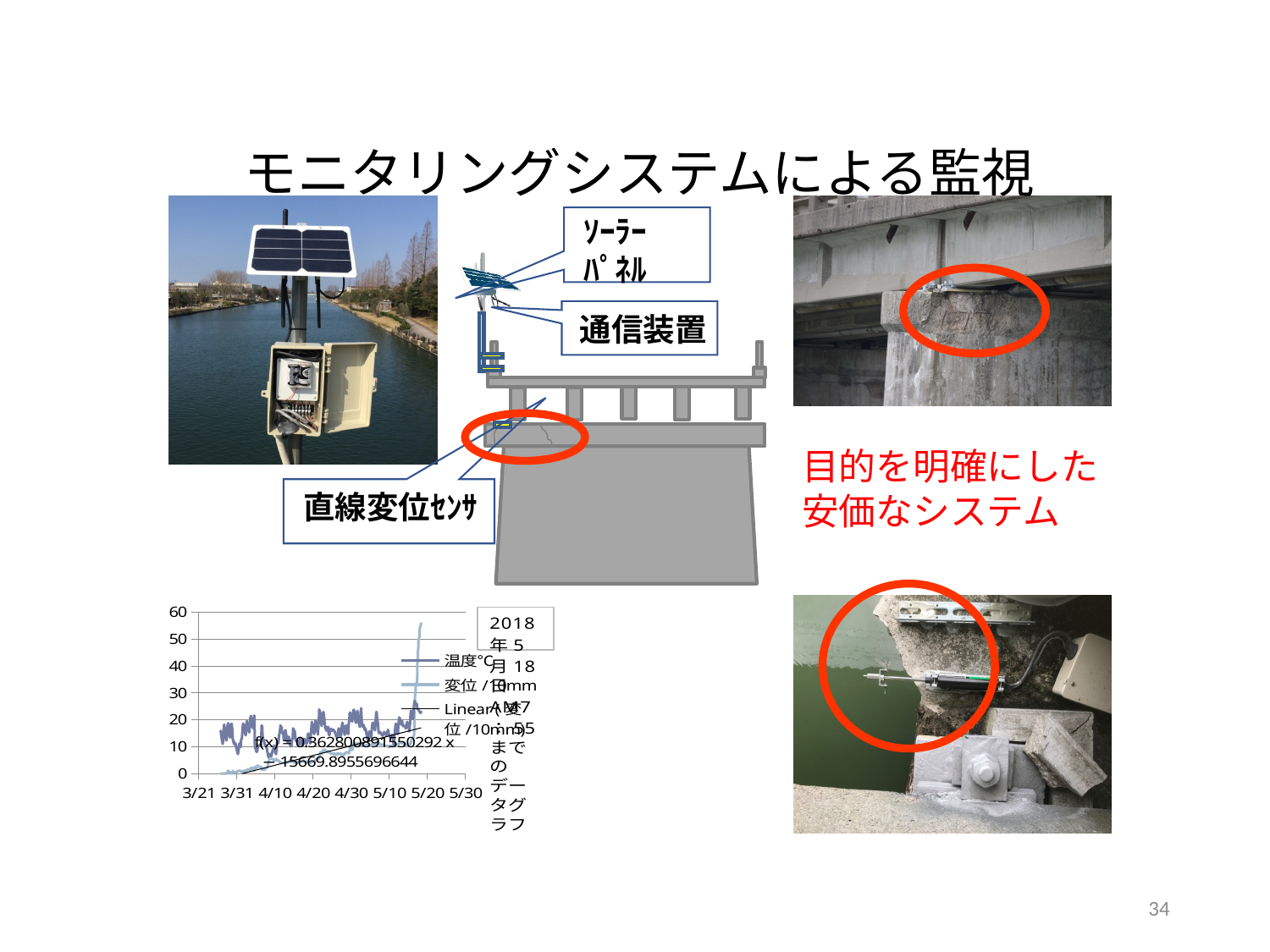
In the bottom-left chart, does the 変位 /10mm series rise or fall overall from 3/21 to 5/20? rise In the bottom-left chart, is the 温度°C series around 4/10 greater or less than 40? less What is the highest value shown on the y axis of the bottom-left chart? 60 What kind of chart is shown at the bottom left of the slide? line chart What is the first date label on the x axis of the bottom-left chart? 3/21 What is the slope coefficient in the trendline equation f(x) printed on the bottom-left chart? 0.362800891550292 What is the second series named in the legend of the bottom-left chart? 変位 /10mm How many series does the legend of the bottom-left chart list? 3 What is the first series named in the legend of the bottom-left chart? 温度°C What is the last date label on the x axis of the bottom-left chart? 5/30 In the bottom-left chart, is the peak value of the 変位 /10mm series near 5/20 greater or less than 40? greater How many date tick labels are shown on the x axis of the bottom-left chart? 8